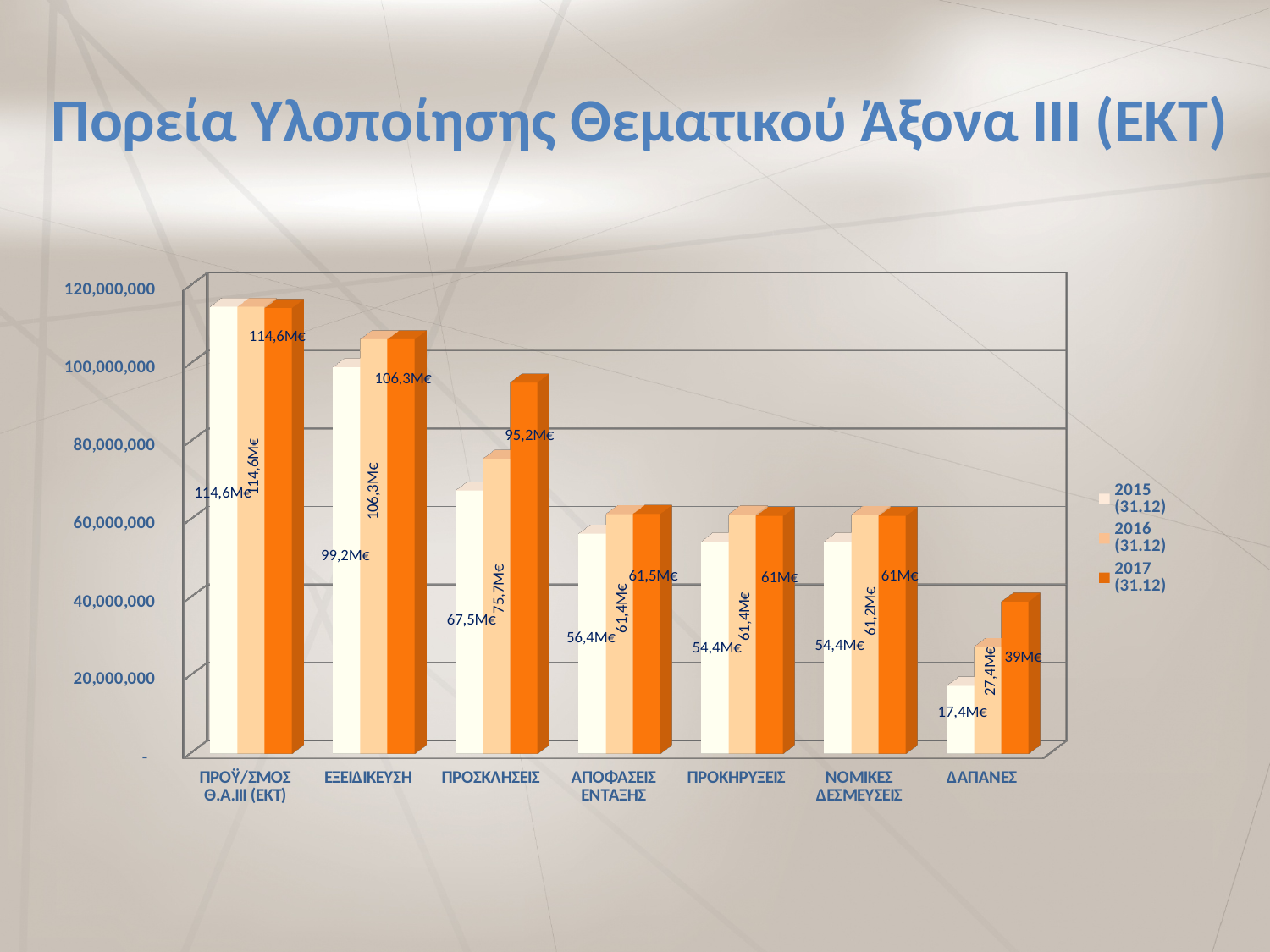
What is the value for ΔΑΠΑΝΕΣ in the 2017 (31.12) series? 39M€ Which category has the highest value in the 2015 (31.12) series? ΠΡΟΫ/ΣΜΟΣ Θ.Α.ΙΙΙ (ΕΚΤ) What is the value for ΕΞΕΙΔΙΚΕΥΣΗ in the 2016 (31.12) series? 106,3M€ What kind of chart is shown on the slide? Bar chart Which is larger for ΔΑΠΑΝΕΣ: the 2016 (31.12) value or the 2017 (31.12) value? 2017 (31.12) What is the difference between the 2017 (31.12) and 2015 (31.12) values for ΠΡΟΣΚΛΗΣΕΙΣ? 27,7M€ Do the values for ΔΑΠΑΝΕΣ rise or fall from 2015 (31.12) to 2017 (31.12)? Rise Which category has the lowest value in the 2017 (31.12) series? ΔΑΠΑΝΕΣ What is the value for ΑΠΟΦΑΣΕΙΣ ΕΝΤΑΞΗΣ in the 2015 (31.12) series? 56,4M€ How many series does the legend list? 3 What is the value for ΠΡΟΣΚΛΗΣΕΙΣ in the 2015 (31.12) series? 67,5M€ How many categories are shown on the x axis? 7